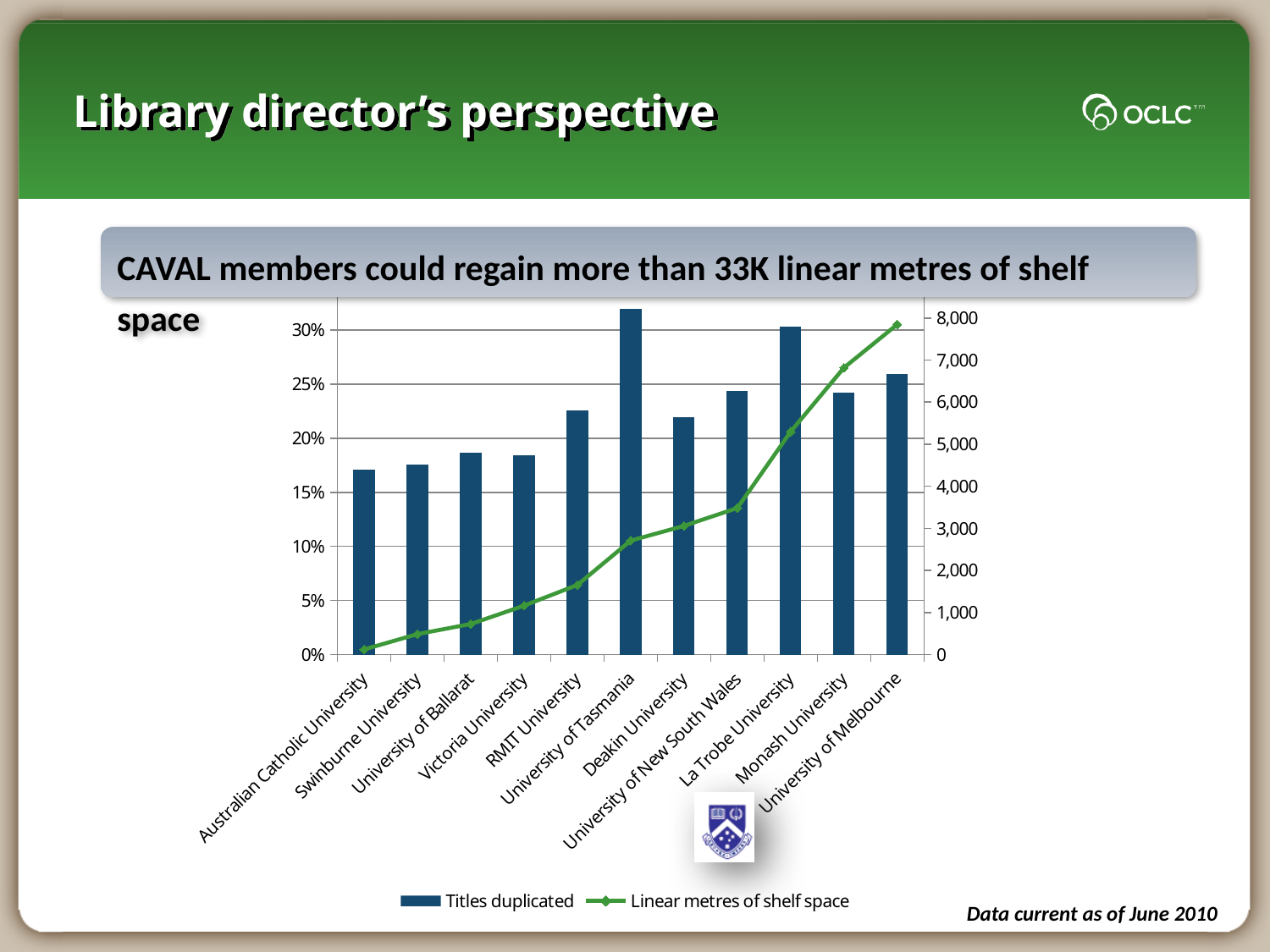
Which university has the lowest value for linear metres of shelf space? Australian Catholic University Which has a higher percentage of titles duplicated, University of Tasmania or La Trobe University? University of Tasmania Does the linear metres of shelf space line rise or fall from left to right across the universities? It rises How many universities are shown along the x axis of the chart? 11 What are the two series named in the chart legend? Titles duplicated; Linear metres of shelf space Is the linear metres of shelf space value for Monash University greater or less than 6,000? greater Is the titles duplicated value for Australian Catholic University greater or less than 20%? less Which university has the highest percentage of titles duplicated? University of Tasmania How many series does the chart legend list? 2 Which university has the highest value for linear metres of shelf space? University of Melbourne Is the titles duplicated value for University of Tasmania greater or less than 30%? greater What kind of chart is shown on the slide? A combination bar and line chart